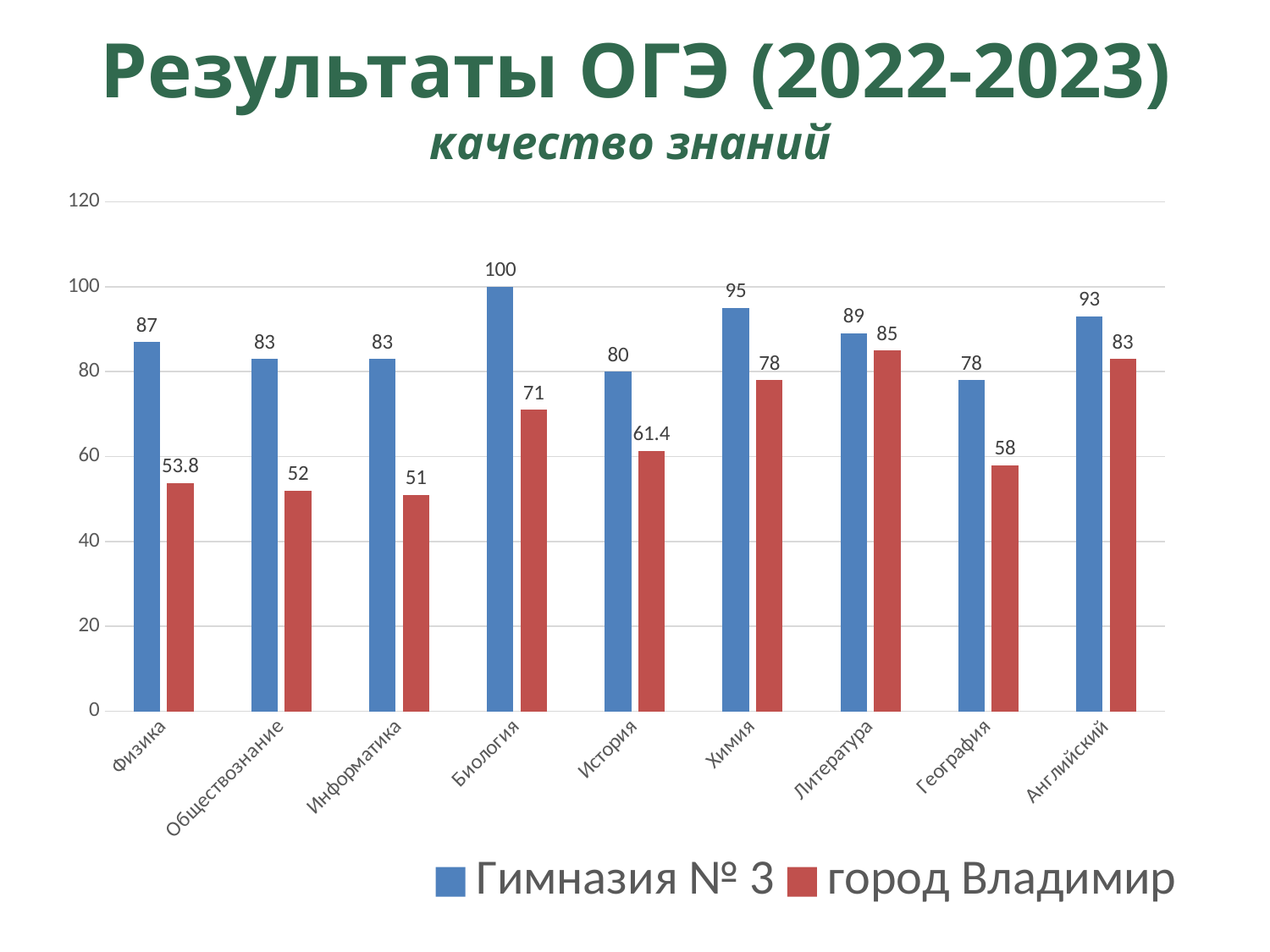
What is the value for город Владимир in Физика? 53.8 How many subjects are shown on the x axis? 9 What is the value for Гимназия № 3 in Биология? 100 What kind of chart is shown on the slide? Bar chart Which is larger in Химия: Гимназия № 3 or город Владимир? Гимназия № 3 What is the value for город Владимир in История? 61.4 Which subject has the highest value for Гимназия № 3? Биология Which subject has the lowest value for город Владимир? Информатика What colour represents город Владимир in the chart? Red How many series does the legend list? 2 What is the difference between Гимназия № 3 and город Владимир in Литература? 4 What is the difference between Гимназия № 3 and город Владимир in Биология? 29